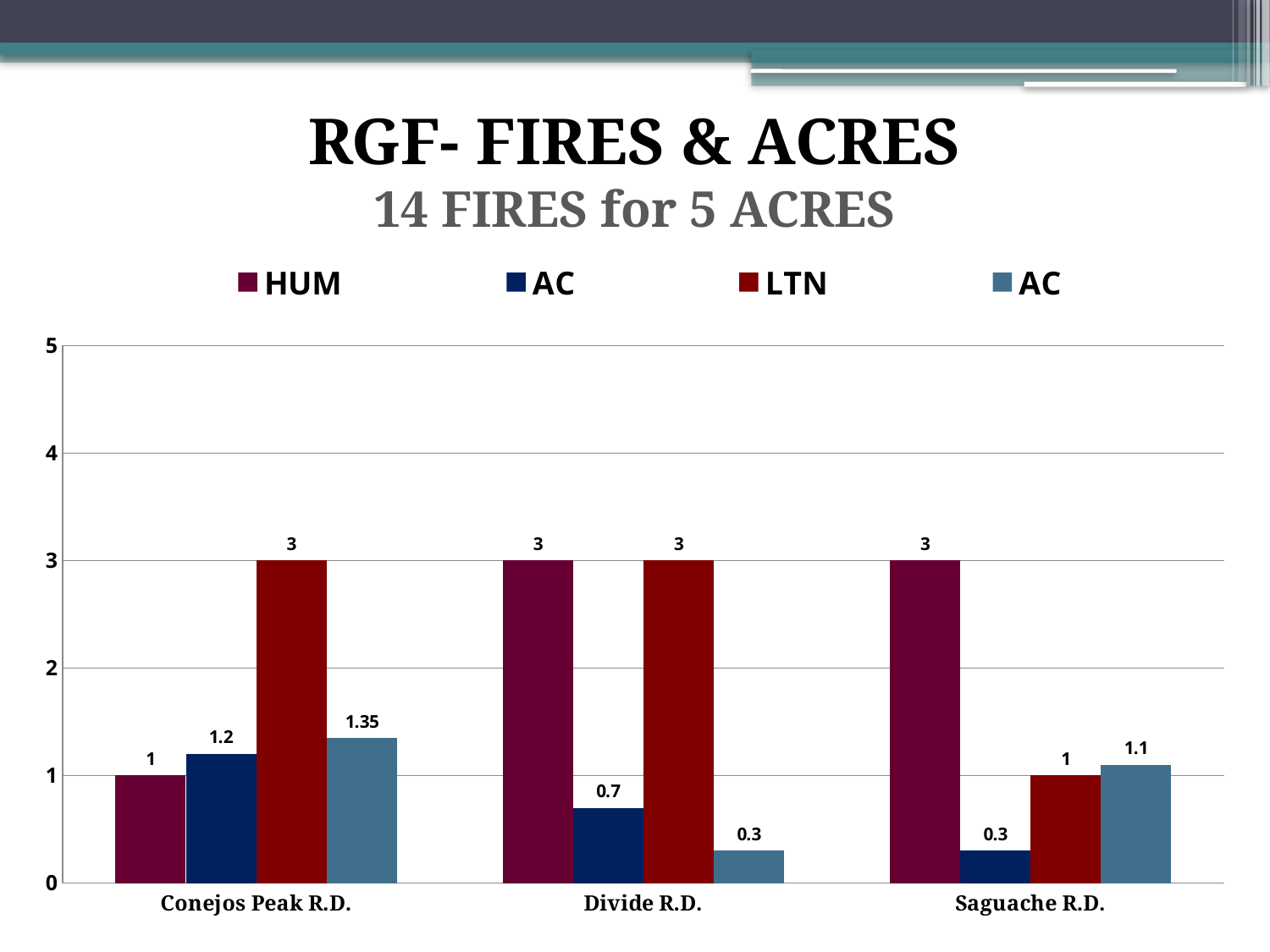
What is the HUM value for Conejos Peak R.D.? 1 Which category has the highest value for the light blue AC series (fourth bar)? Conejos Peak R.D. What is the value of the dark blue AC series (second bar) for Divide R.D.? 0.7 What is the difference between the LTN value and the HUM value for Conejos Peak R.D.? 2 Which category has the lowest HUM value? Conejos Peak R.D. What is the subtitle shown below the main title of the slide? 14 FIRES for 5 ACRES What is the LTN value for Saguache R.D.? 1 How many series does the legend list? 4 What kind of chart is shown on the slide? Bar chart What is the value of the light blue AC series (fourth bar) for Conejos Peak R.D.? 1.35 How many categories are shown on the x axis? 3 Which is larger for Saguache R.D.: the HUM value or the LTN value? HUM